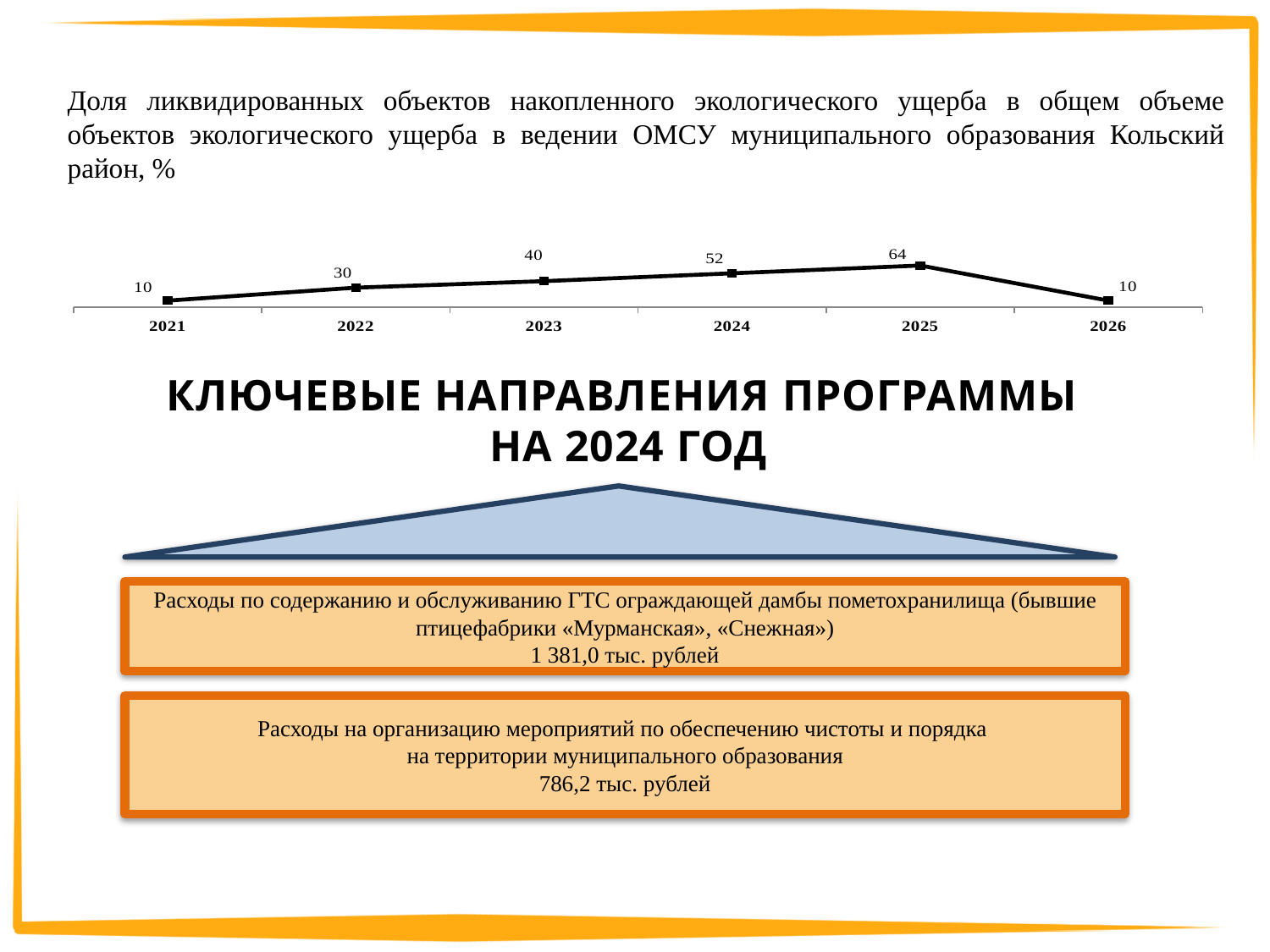
What kind of chart is shown on the slide? line chart Which year has the highest value on the line chart? 2025 How many years are plotted on the line chart? 6 What is the value for 2021 on the line chart? 10 What is the difference between the values for 2024 and 2021 on the line chart? 42 Do the values on the line chart rise or fall from 2025 to 2026? fall Do the values on the line chart rise or fall from 2021 to 2025? rise Which is larger on the line chart, the value for 2022 or the value for 2026? 2022 What is the value for 2025 on the line chart? 64 What is the value for 2023 on the line chart? 40 What is the difference between the values for 2025 and 2024 on the line chart? 12 What is the value for 2022 on the line chart? 30